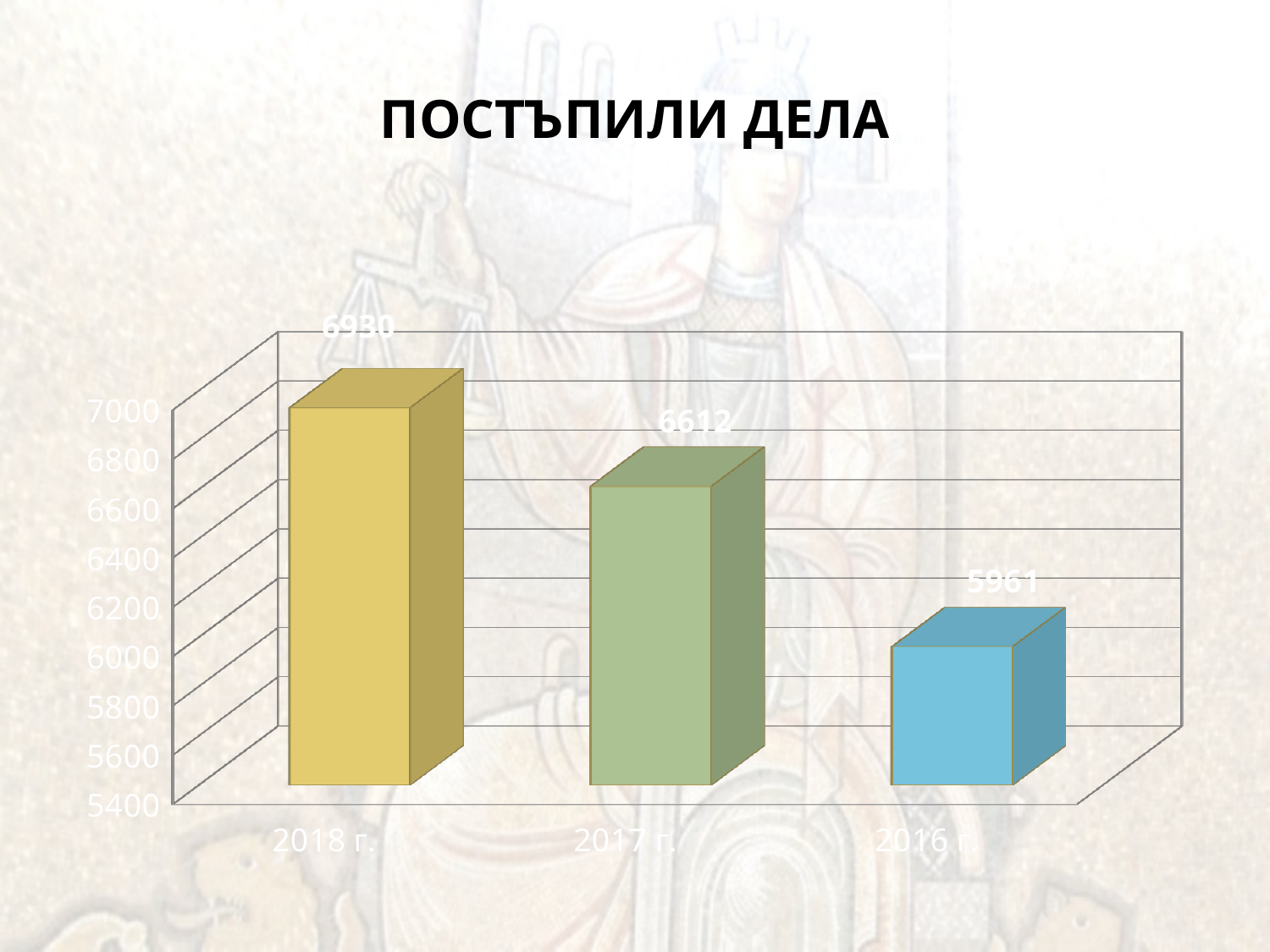
Which year has the highest value? 2018 г. What is the difference between the values for 2017 г. and 2016 г.? 651 How many categories are shown on the chart? 3 What is the value for 2016 г.? 5961 Which is larger, the value for 2017 г. or the value for 2016 г.? 2017 г. What is the value for 2018 г.? 6930 What is the title of the chart? ПОСТЪПИЛИ ДЕЛА What kind of chart is shown on the slide? bar chart What is the difference between the values for 2018 г. and 2017 г.? 318 Is the value for 2016 г. greater or less than 6000? less What is the value for 2017 г.? 6612 Which year has the lowest value? 2016 г.